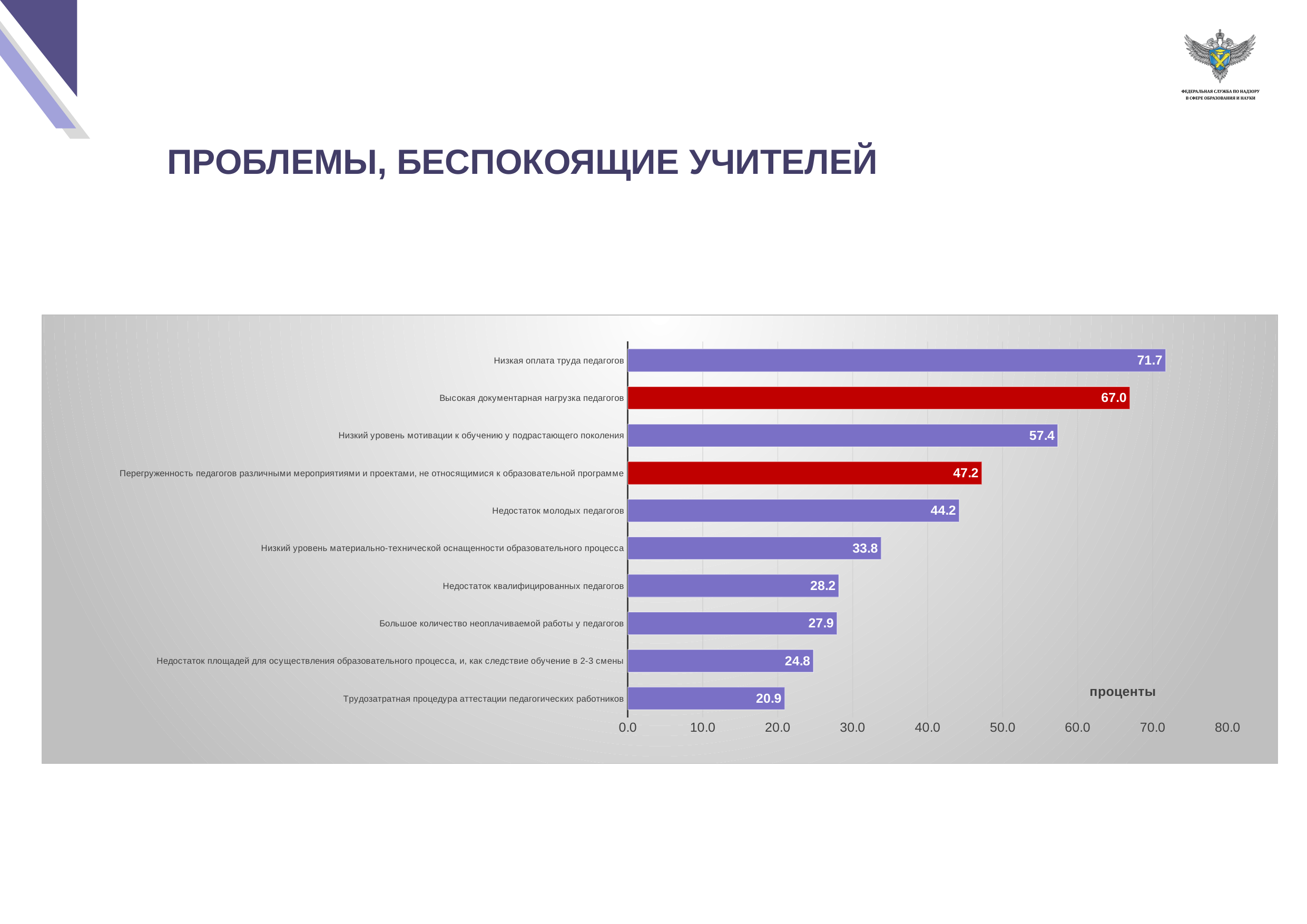
What is the label shown on the horizontal axis of the chart? проценты What is the value for «Высокая документарная нагрузка педагогов»? 67.0 How many categories are shown in the chart? 10 Which category has the lowest value? Трудозатратная процедура аттестации педагогических работников Which category has the highest value? Низкая оплата труда педагогов What is the value for «Недостаток молодых педагогов»? 44.2 Is the value for «Низкий уровень мотивации к обучению у подрастающего поколения» greater or less than 50.0? greater Which is larger: the value for «Недостаток квалифицированных педагогов» or for «Большое количество неоплачиваемой работы у педагогов»? Недостаток квалифицированных педагогов What is the value for «Низкая оплата труда педагогов»? 71.7 What is the difference between the values for «Низкая оплата труда педагогов» and «Высокая документарная нагрузка педагогов»? 4.7 What kind of chart is shown on the slide? Bar chart What is the value for «Трудозатратная процедура аттестации педагогических работников»? 20.9